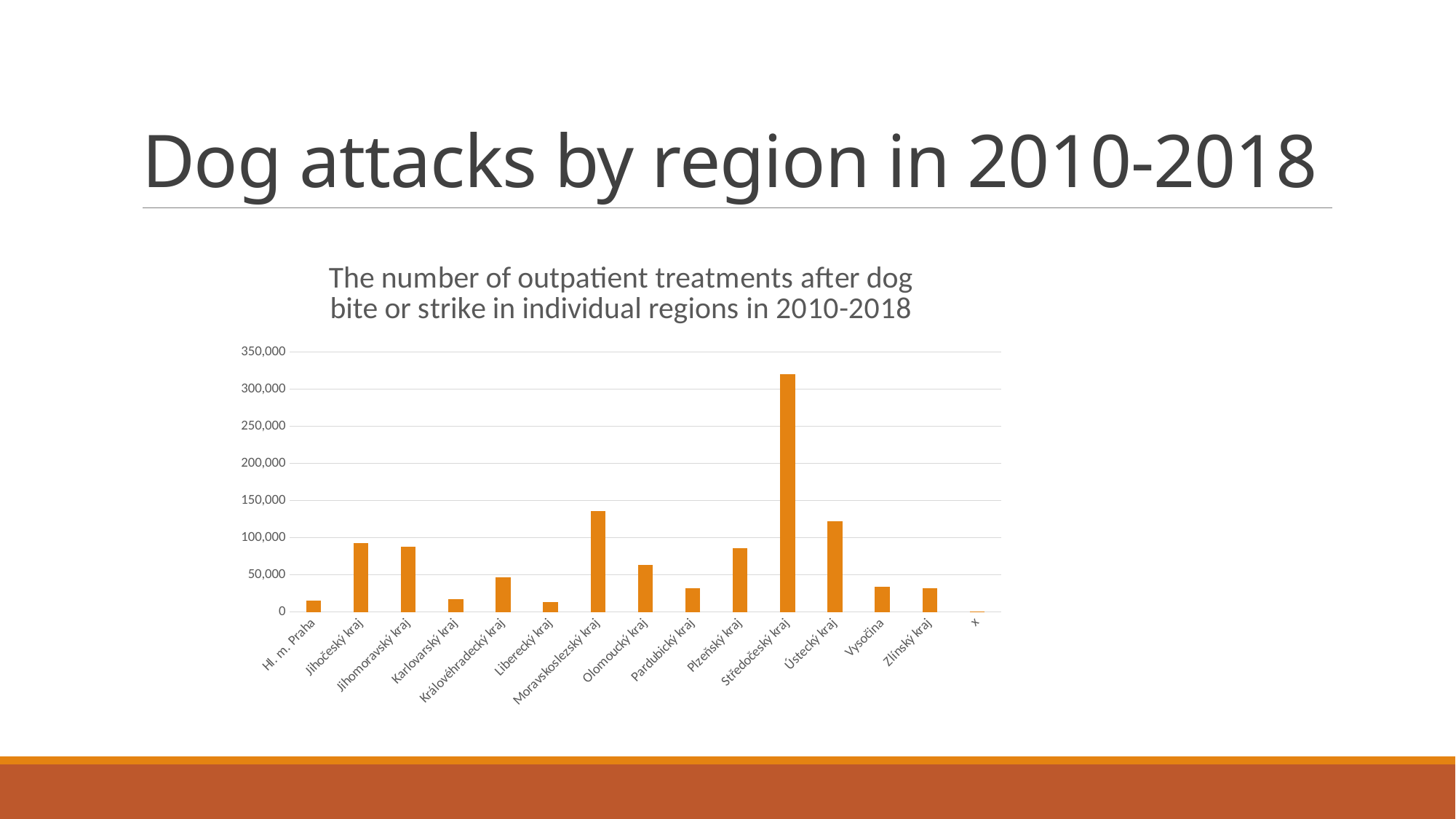
Is the value for Karlovarský kraj greater or less than 50,000? less Which has a higher value, Plzeňský kraj or Olomoucký kraj? Plzeňský kraj What kind of chart is shown on the slide? Bar chart How many categories are shown on the x axis of the chart? 15 What is the title of the chart? The number of outpatient treatments after dog bite or strike in individual regions in 2010-2018 Is the value for Plzeňský kraj greater or less than 50,000? greater Which has a higher value, Moravskoslezský kraj or Ústecký kraj? Moravskoslezský kraj Which region has the highest number of outpatient treatments in the chart? Středočeský kraj What colour are the bars in the chart? Orange Is the value for Moravskoslezský kraj greater or less than 100,000? greater